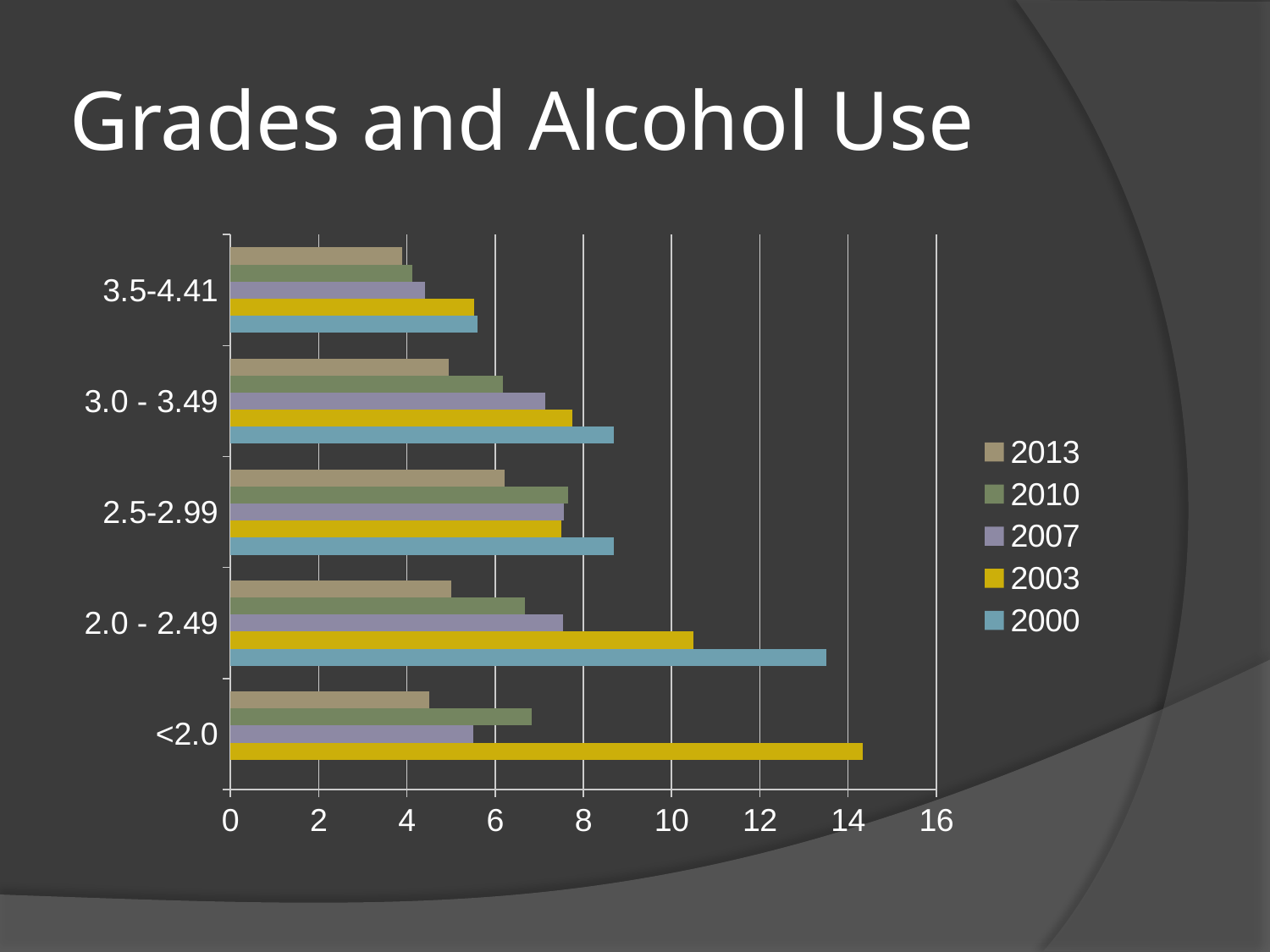
How many series does the legend list? 5 How many grade categories are shown on the vertical axis? 5 What is the title of the chart? Grades and Alcohol Use Which year's bar is the longest in the 3.0 - 3.49 category? 2000 Is the value for 2003 in the <2.0 category greater or less than 12? greater Which year's bar is the longest in the 2.0 - 2.49 category? 2000 Which year is listed last in the legend? 2000 Is the value for 2013 in the 3.5-4.41 category greater or less than 6? less Which year's bar is the longest in the <2.0 category? 2003 Is the value for 2000 in the 2.0 - 2.49 category greater or less than 12? greater In the <2.0 category, which is larger, the value for 2003 or the value for 2013? 2003 What kind of chart is shown on the slide? bar chart